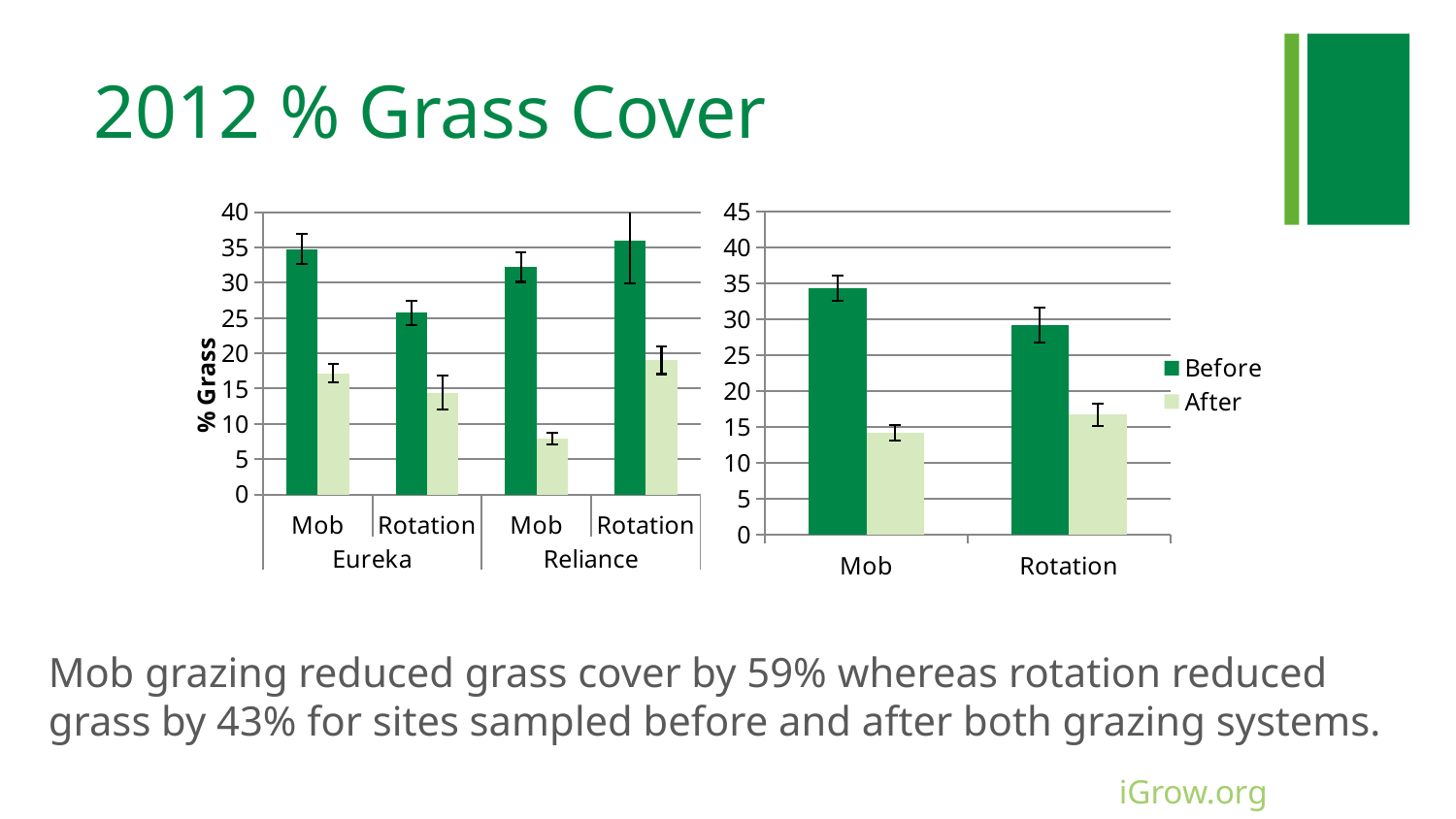
In the left chart, which bar is the lowest? Reliance Mob After How many categories are shown on the x axis of the right chart? 2 What kind of chart is the chart on the right of the slide? bar chart How many series does the legend on the right chart list? 2 In the right chart, which has the larger After value, Mob or Rotation? Rotation In the right chart, which has the larger Before value, Mob or Rotation? Mob In the right chart, is the After value for Rotation greater or less than 20? less What are the two series named in the legend of the right chart? Before and After In the left chart, is the After value for Mob at Reliance greater or less than 10? less In the right chart, is the Before value for Mob greater or less than 30? greater In the left chart, which is larger, the After value for Mob at Eureka or the After value for Mob at Reliance? Mob at Eureka What is the y-axis label on the left chart? % Grass